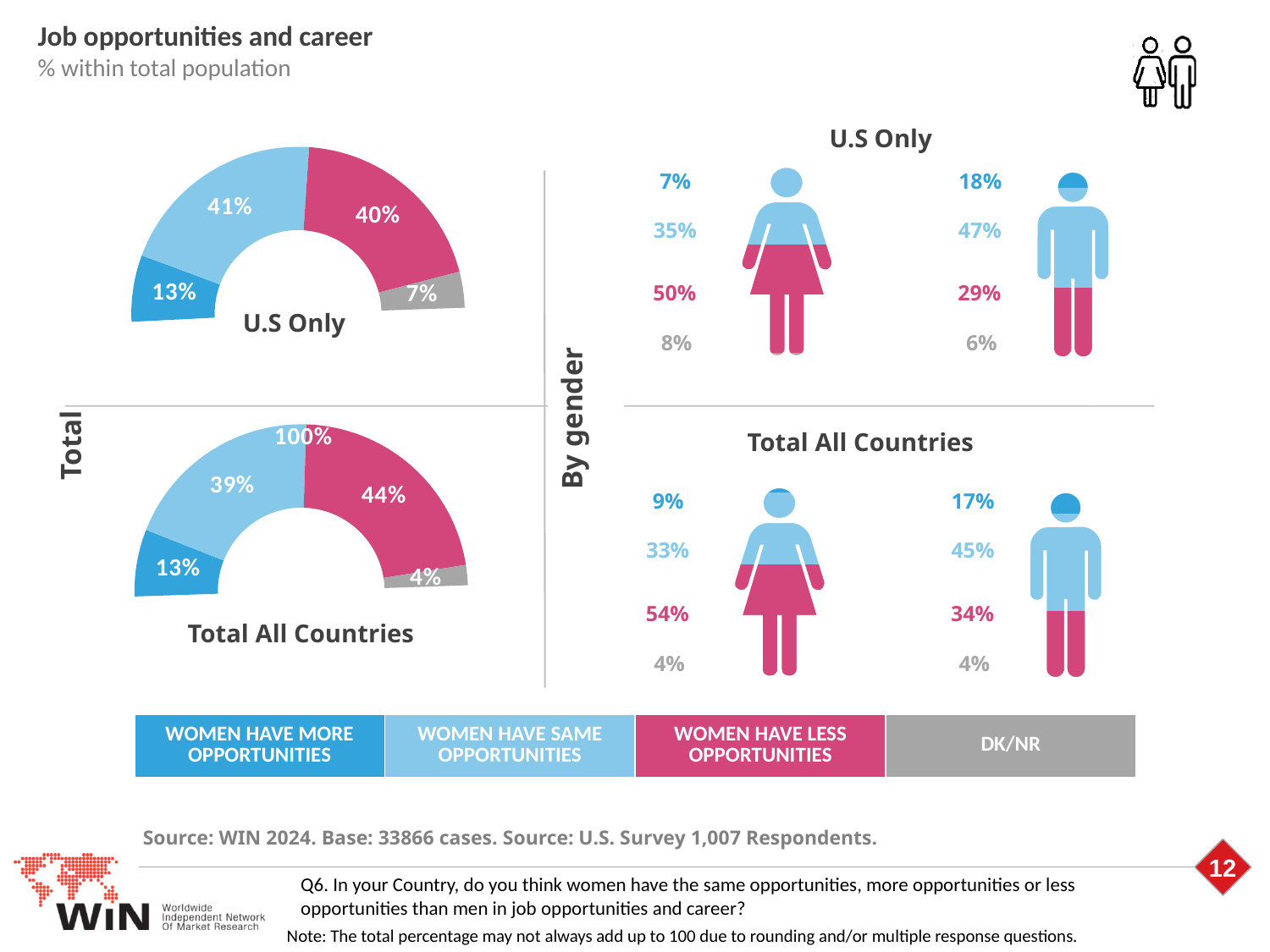
In the Total All Countries donut chart, what percentage say women have less opportunities? 44% In the By gender U.S Only figures, what percentage of men say women have the same opportunities? 47% In the By gender Total All Countries figures, what percentage of women say women have less opportunities? 54% In the Total All Countries donut chart, which response category has the highest share? Women have less opportunities In the U.S Only donut chart, which response category has the lowest share? DK/NR In the By gender U.S Only figures, what percentage of women say women have less opportunities? 50% In the U.S Only donut chart, what is the difference between the share saying women have the same opportunities and the share saying women have more opportunities? 28% What colour represents 'Women have less opportunities' in the legend? Pink/magenta In the Total All Countries donut chart, which is larger: the share saying women have less opportunities or the share saying women have the same opportunities? Women have less opportunities How many response categories does the legend at the bottom of the slide list? 4 In the U.S Only donut chart, what percentage say women have the same opportunities? 41% In the By gender Total All Countries figures, what is the difference between the share of women and the share of men who say women have less opportunities? 20%